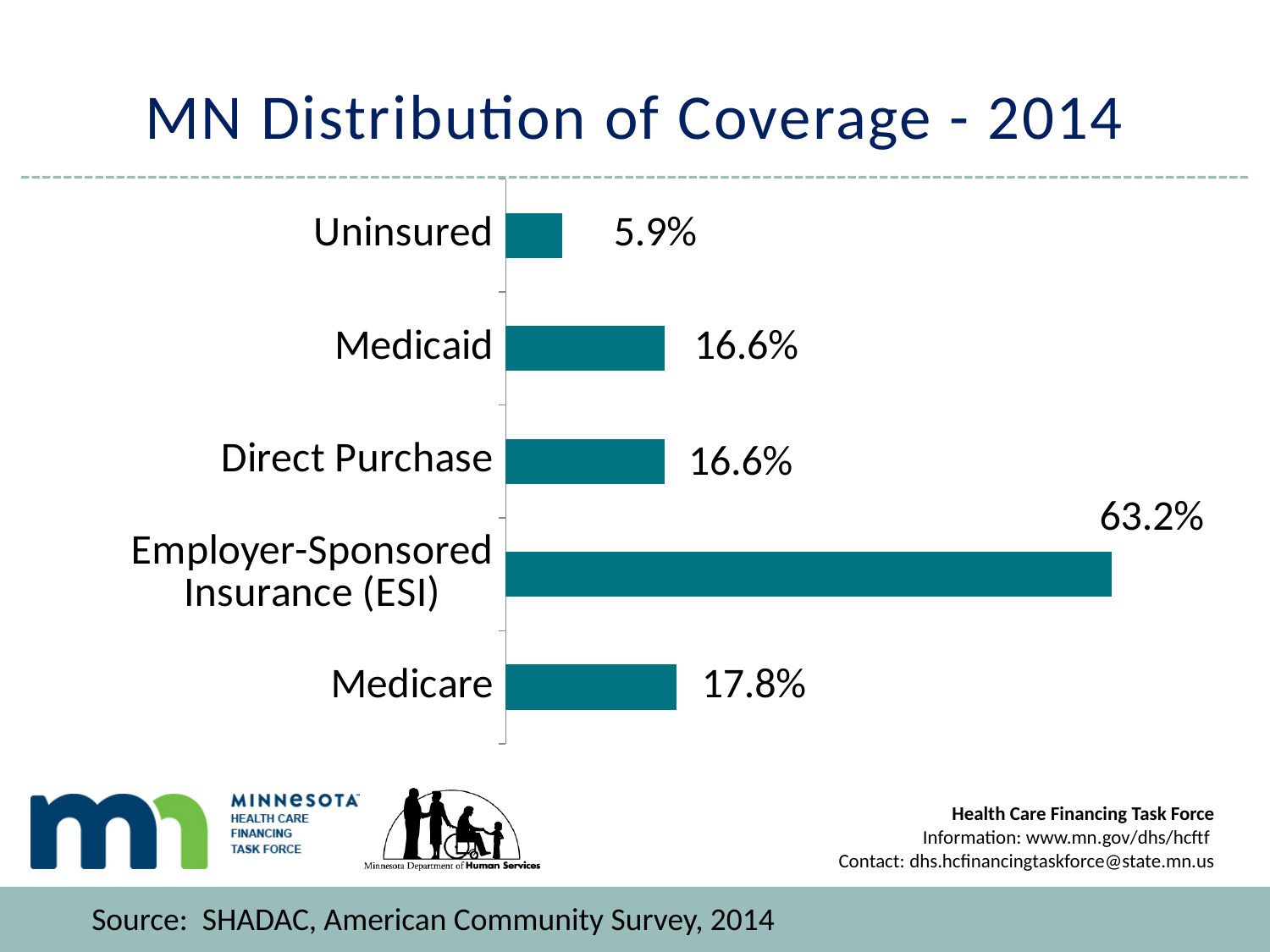
How many categories are shown in the chart? 5 What is the difference between the values for Employer-Sponsored Insurance (ESI) and Medicare? 45.4% Which category has the highest value? Employer-Sponsored Insurance (ESI) What is the difference between the values for Medicare and Uninsured? 11.9% What kind of chart is shown on the slide? Bar chart What is the title of the chart? MN Distribution of Coverage - 2014 What is the value for Employer-Sponsored Insurance (ESI)? 63.2% Which is larger, the value for Medicare or the value for Medicaid? Medicare Which category has the lowest value? Uninsured What is the value for Medicare? 17.8% What is the value for Uninsured? 5.9% What is the value for Medicaid? 16.6%